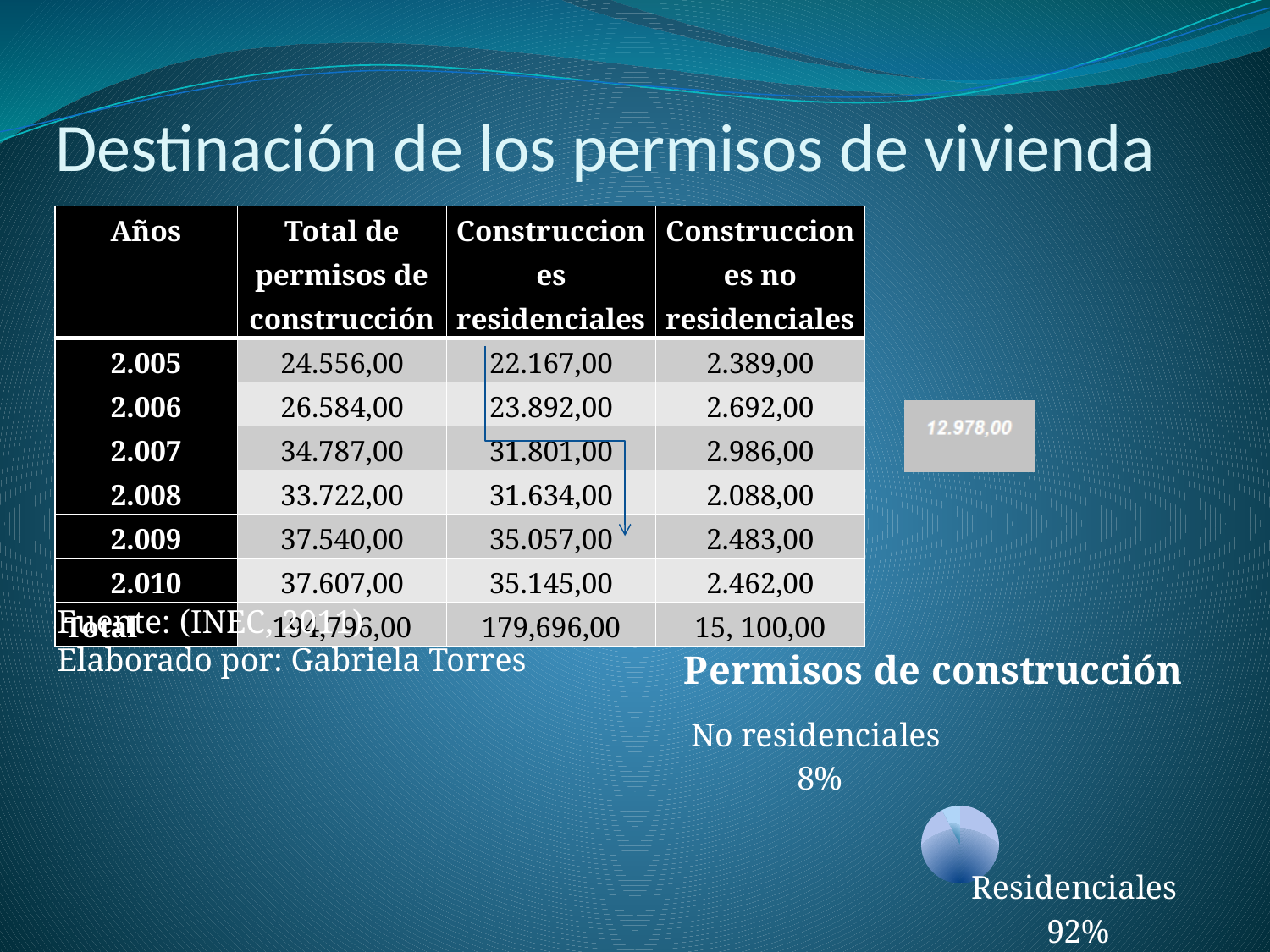
What is the title of the pie chart? Permisos de construcción Is the share for Residenciales in the pie chart greater or less than 50%? greater In the pie chart, what share is labelled for No residenciales? 8% Which slice of the pie chart is the smallest? No residenciales Which slice of the pie chart is the largest? Residenciales What are the two category labels shown on the pie chart? No residenciales and Residenciales In the pie chart, by how many percentage points does Residenciales exceed No residenciales? 84 In the pie chart, what share is labelled for Residenciales? 92% What kind of chart is shown at the bottom right of the slide? pie chart In the pie chart, which is larger: Residenciales or No residenciales? Residenciales How many slices does the pie chart have? 2